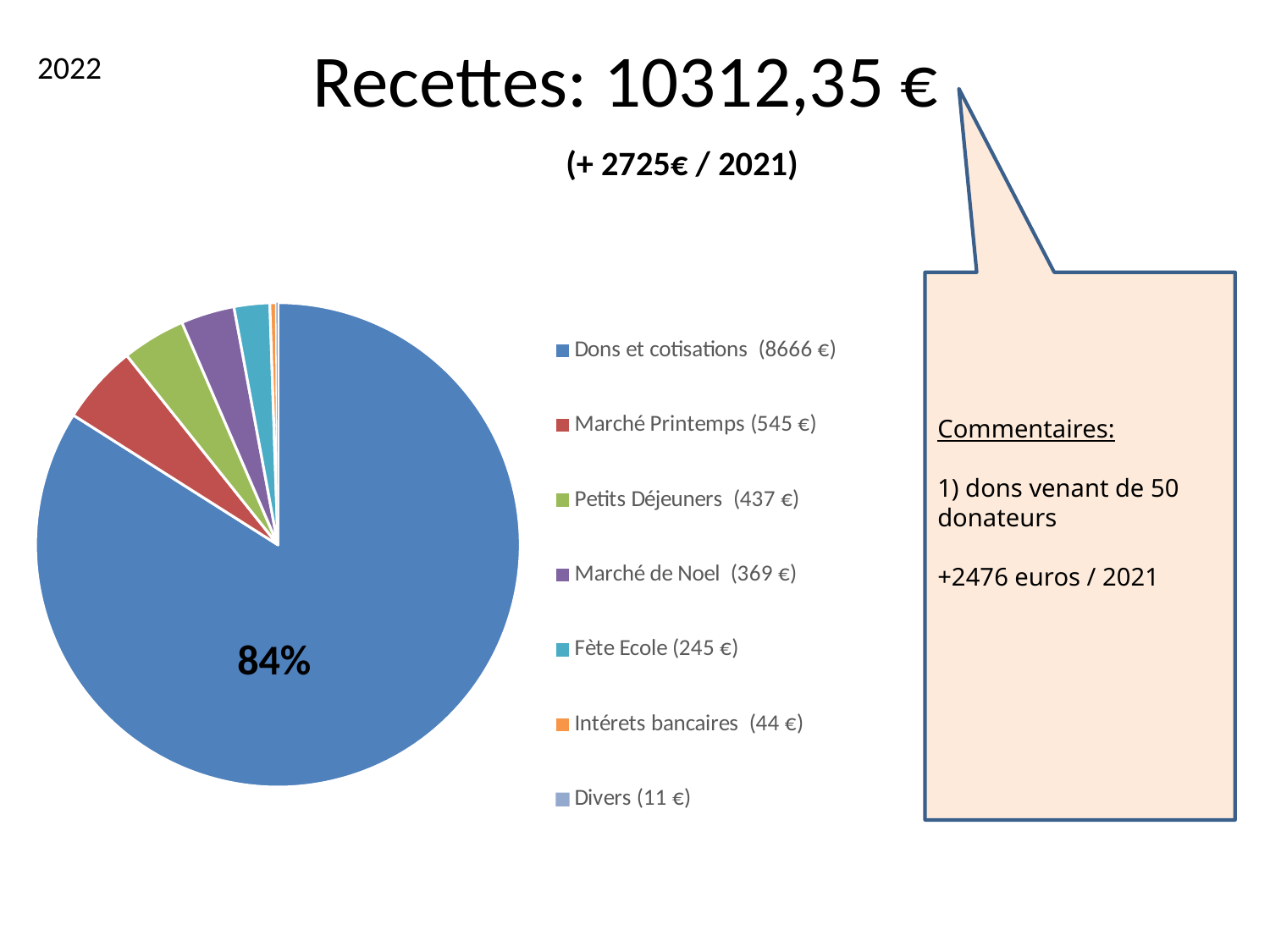
What kind of chart is shown on the slide? pie chart Which is larger, the value for Petits Déjeuners or the value for Fète Ecole? Petits Déjeuners What colour is the slice for Dons et cotisations? blue Which category has the largest slice of the pie? Dons et cotisations What is the difference between the values for Intérets bancaires and Divers? 33 € How many categories does the pie chart's legend list? 7 What value is shown in the legend for Petits Déjeuners? 437 € What value is shown in the legend for Fète Ecole? 245 € Which category has the smallest value in the legend? Divers What is the difference between the values for Marché Printemps and Marché de Noel? 176 € What value is shown in the legend for Marché Printemps? 545 € What percentage share is labelled on the largest slice of the pie? 84%